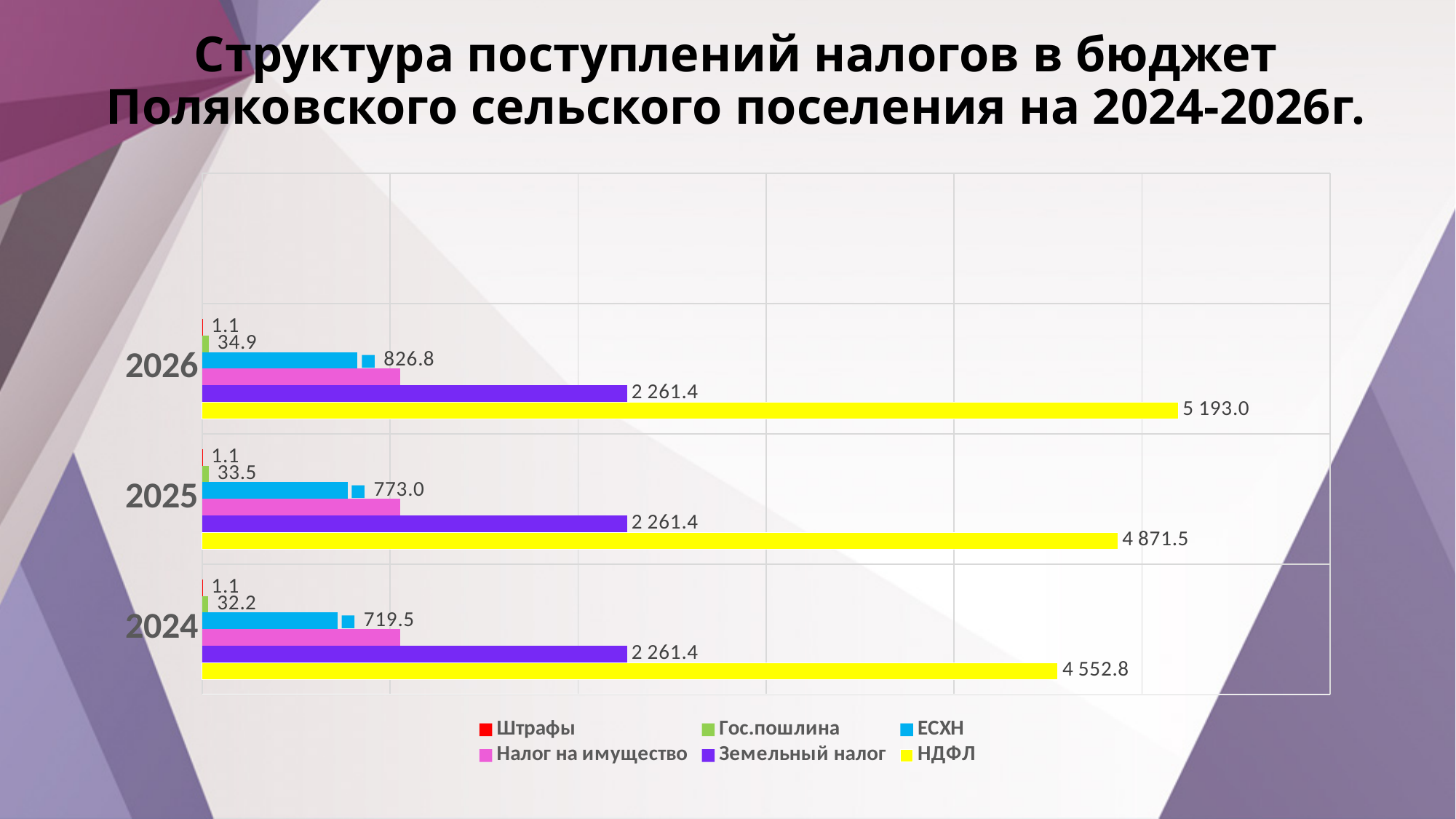
What is the value of Гос.пошлина for 2025? 33.5 How many series does the legend list? 6 What is the value of НДФЛ for 2026? 5 193.0 Does the value of НДФЛ rise or fall from 2024 to 2026? Rises What is the value of ЕСХН for 2024? 719.5 What is the difference between НДФЛ in 2026 and НДФЛ in 2024? 640.2 Which is larger in 2025: Земельный налог or ЕСХН? Земельный налог In which year is НДФЛ the highest? 2026 How many years (categories) are shown on the chart? 3 What is the value of Земельный налог for 2025? 2 261.4 In which year is ЕСХН the lowest? 2024 What type of chart is shown on the slide? Bar chart